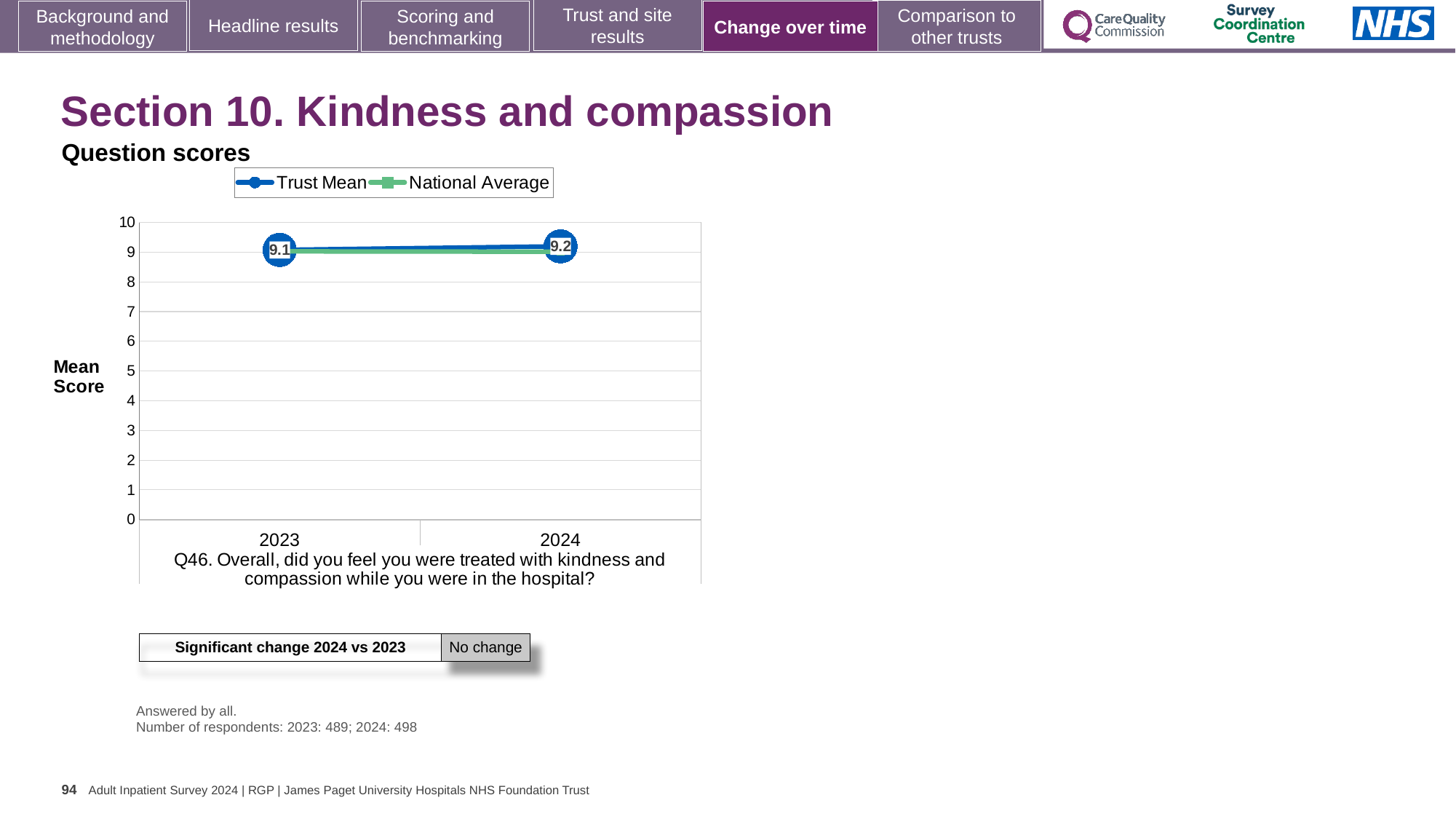
Does the Trust Mean score rise or fall from 2023 to 2024? rise What is the Trust Mean score for 2023? 9.1 By how much did the Trust Mean score change from 2023 to 2024? 0.1 What kind of chart is shown on the slide? line chart Is the Trust Mean score for 2023 greater or less than 8? greater What are the two series named in the legend? Trust Mean and National Average What is the Trust Mean score for 2024? 9.2 Which year has the higher Trust Mean score, 2023 or 2024? 2024 Is the National Average score for 2024 greater or less than 5? greater How many series does the legend list? 2 What is the label on the y axis of the chart? Mean Score How many years are plotted on the x axis? 2